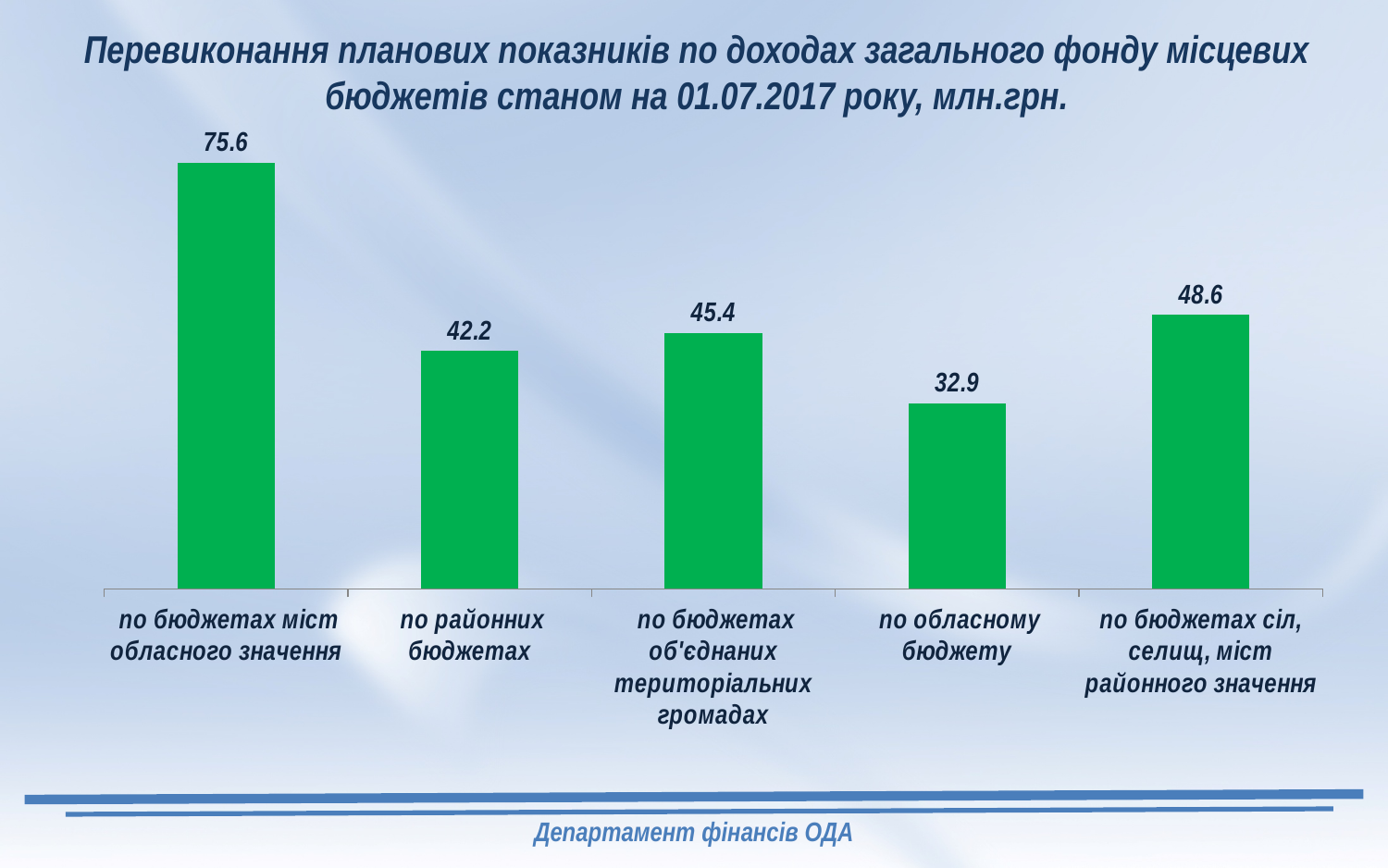
What is the value for "по бюджетах сіл, селищ, міст районного значення"? 48.6 Which category has the highest value? по бюджетах міст обласного значення Which category has the lowest value? по обласному бюджету What is the value for "по бюджетах об'єднаних територіальних громадах"? 45.4 What is the difference between the values for "по бюджетах міст обласного значення" and "по обласному бюджету"? 42.7 What kind of chart is shown on the slide? bar chart What colour are the bars in the chart? green How many categories are shown in the chart? 5 What is the value for "по обласному бюджету"? 32.9 What is the value for "по бюджетах міст обласного значення"? 75.6 What is the difference between the values for "по бюджетах сіл, селищ, міст районного значення" and "по районних бюджетах"? 6.4 Which is larger: the value for "по районних бюджетах" or for "по бюджетах об'єднаних територіальних громадах"? по бюджетах об'єднаних територіальних громадах